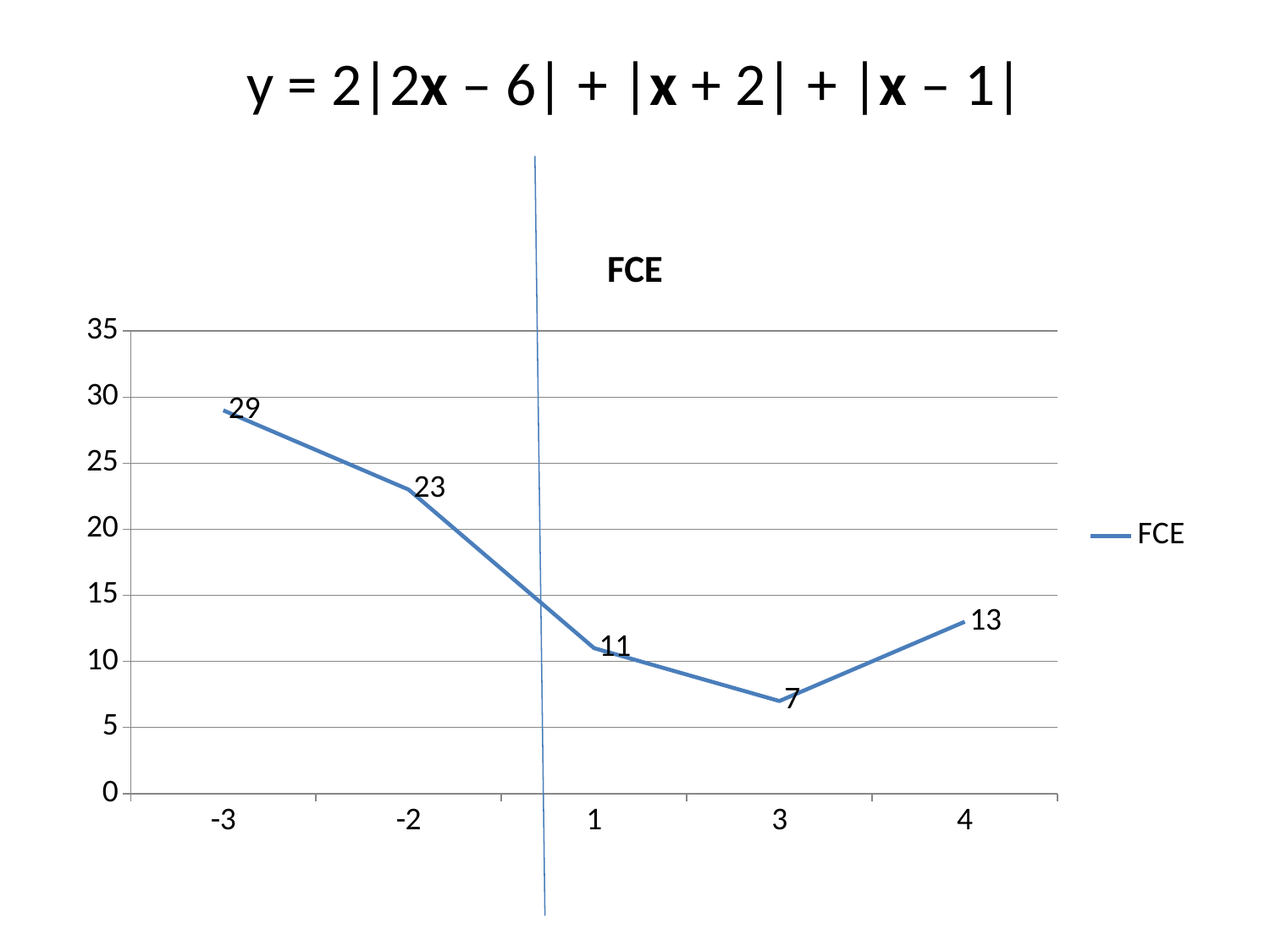
How many series does the legend list? 1 At which x value is FCE lowest? 3 What is the value of FCE at x = -3? 29 What kind of chart is shown? line chart At which x value is FCE highest? -3 Is the FCE value at x = -2 greater or less than 20? greater Which is larger, the FCE value at x = 1 or at x = 4? x = 4 What is the value of FCE at x = 3? 7 What is the title of the chart? FCE What is the value of FCE at x = 4? 13 What is the difference between the FCE values at x = -2 and x = 1? 12 How many data points are plotted on the chart? 5